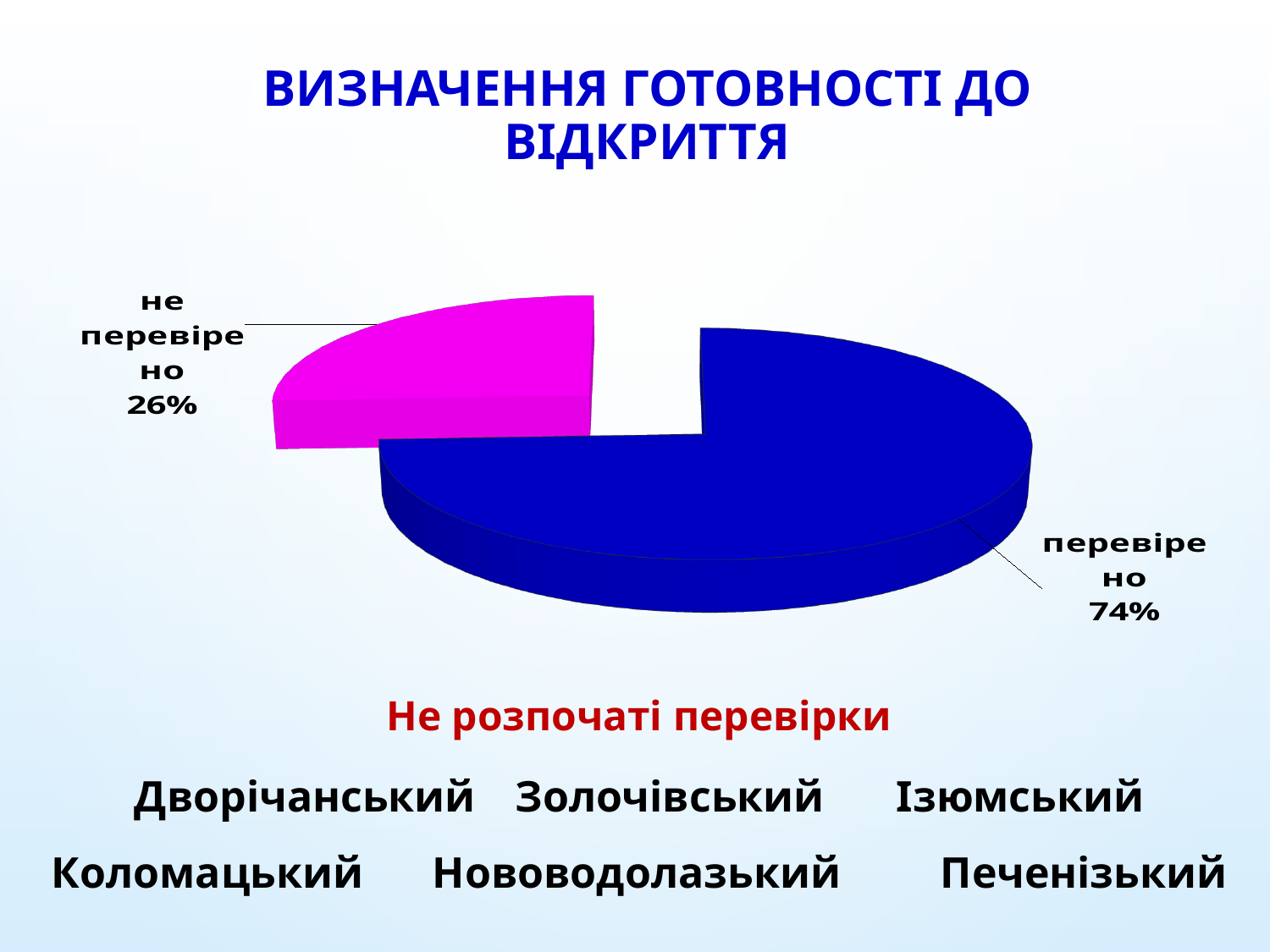
What is the total of the two pie slice percentages? 100% What share of the pie is labelled "не перевірено"? 26% What kind of chart is shown on the slide? pie chart Which slice of the pie is the smallest? не перевірено Is the share for "перевірено" greater or less than 50%? greater What colour is the "перевірено" slice? blue What colour is the "не перевірено" slice? magenta Which is larger, the "перевірено" slice or the "не перевірено" slice? перевірено What share of the pie is labelled "перевірено"? 74% What is the difference in percentage points between the "перевірено" and "не перевірено" slices? 48 Which slice of the pie is the largest? перевірено How many slices does the pie chart have? 2